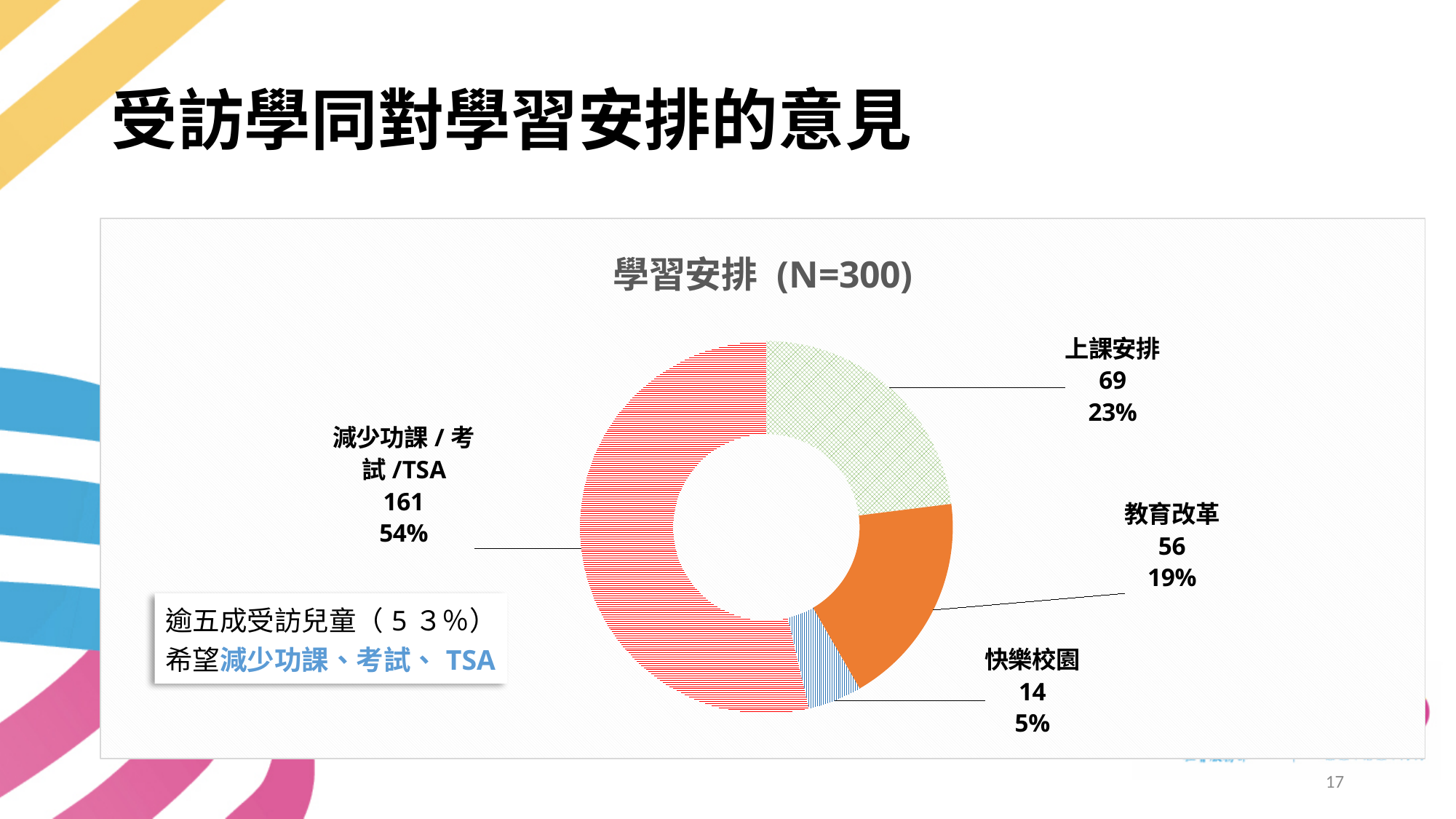
What percentage share does 快樂校園 have? 5% What is the difference in count between 上課安排 and 教育改革? 13 How many categories does the chart show? 4 Which has a larger count, 教育改革 or 快樂校園? 教育改革 What is the title of the chart? 學習安排 (N=300) Which category has the highest count? 減少功課 / 考試 /TSA What is the count for 教育改革? 56 What kind of chart is shown on the slide? Doughnut (pie) chart Which category has the lowest count? 快樂校園 What is the count for 減少功課 / 考試 /TSA? 161 What percentage share does 上課安排 have? 23% What is the total count across all four categories? 300